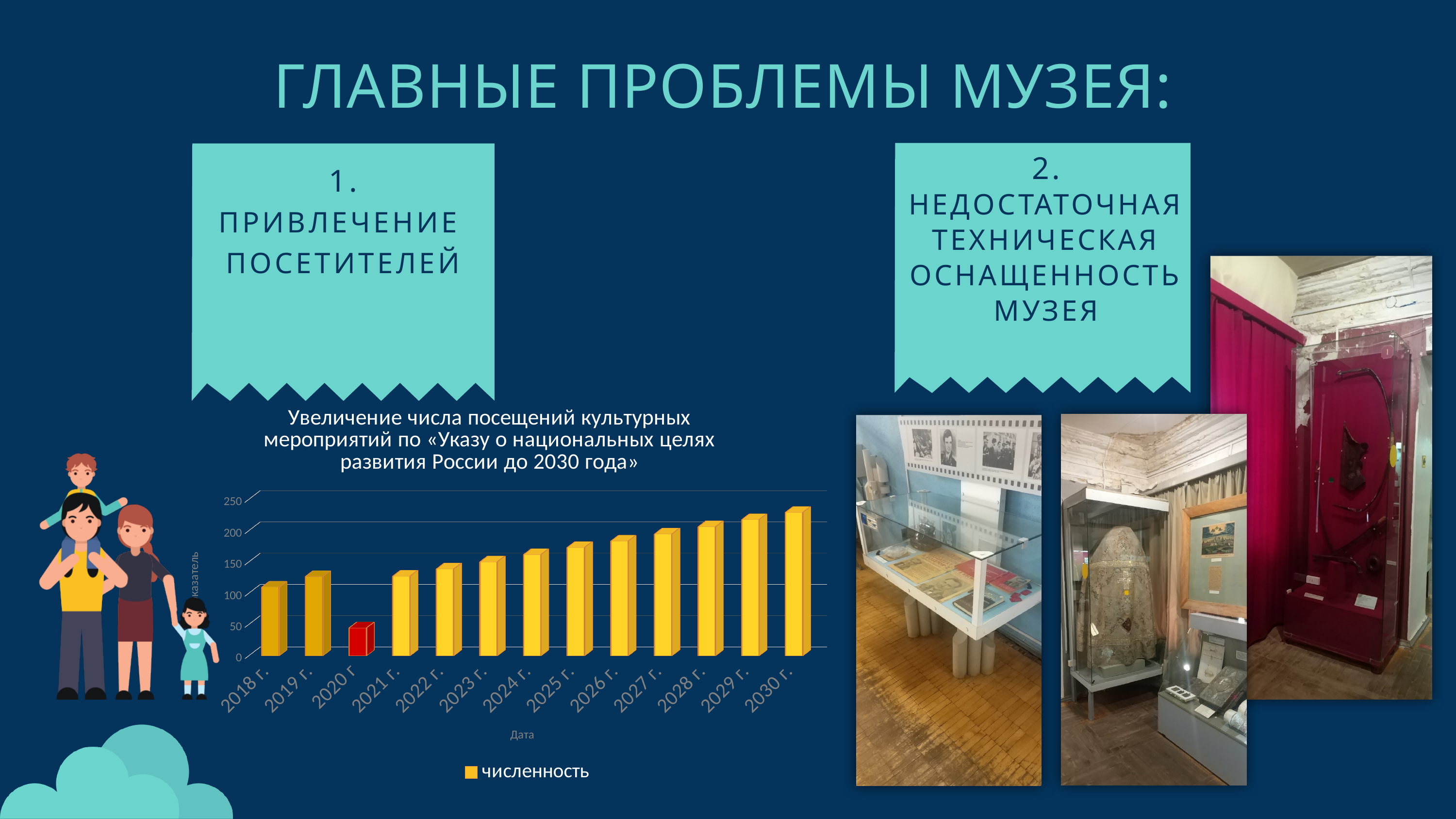
Is the value for 2030 г. greater or less than 200? greater Which year has the lowest bar in the chart? 2020 г Which is larger, the value for 2018 г. or the value for 2030 г.? 2030 г. Is the value for 2020 г greater or less than 100? less Which year has the highest bar in the chart? 2030 г. Which year's bar is coloured red instead of yellow? 2020 г How many years (categories) are shown on the x axis of the chart? 13 Is the value for 2025 г. greater or less than 150? greater What is the name of the series shown in the chart legend? численность What kind of chart is shown on the slide? bar chart Do the values rise or fall from 2021 г. to 2030 г.? rise How many series does the chart legend list? 1